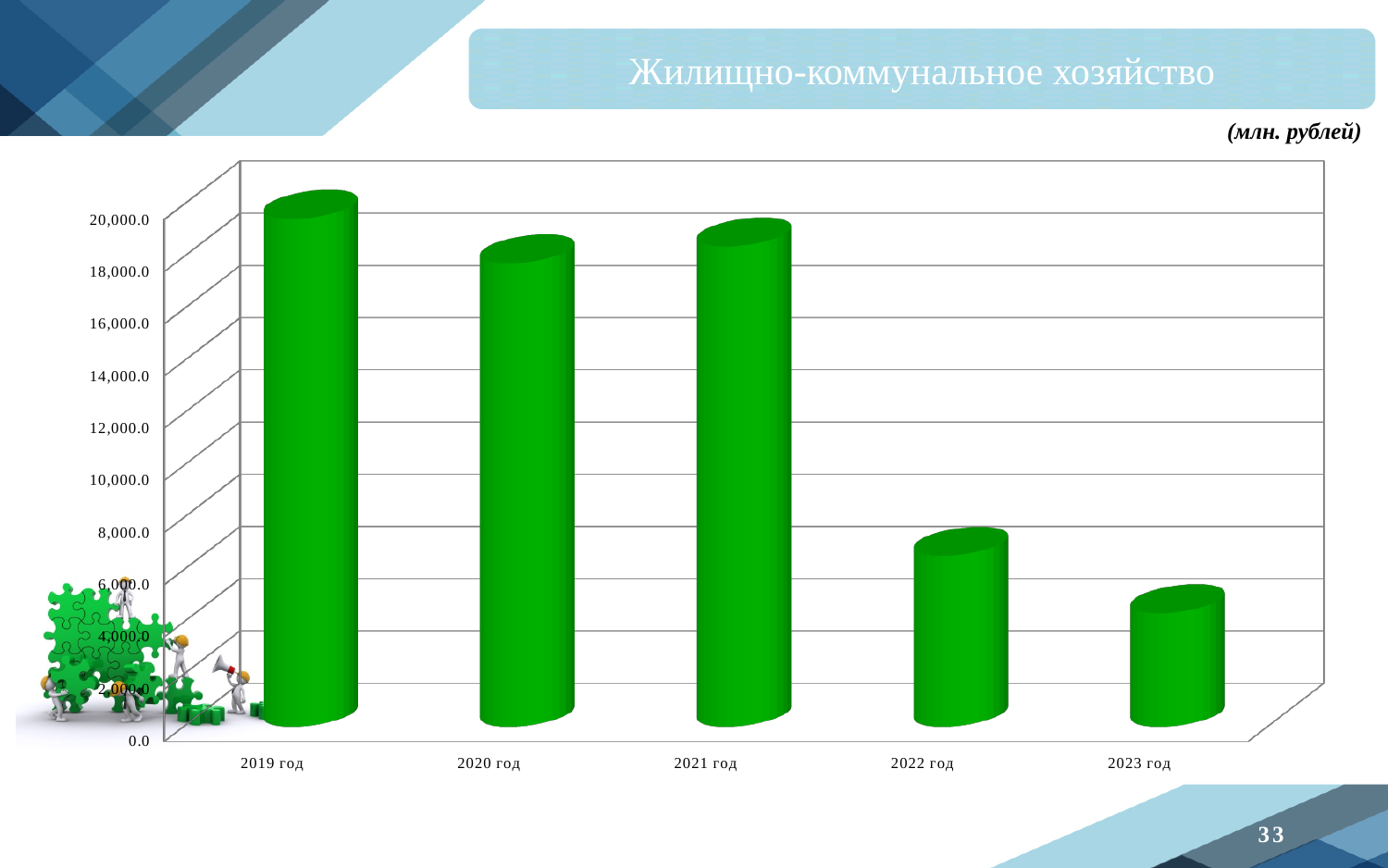
Is the value for 2023 год greater or less than 8,000.0? less What is the title of the chart on the slide? Жилищно-коммунальное хозяйство Is the value for 2022 год greater or less than 10,000.0? less Do the values generally rise or fall from 2019 год to 2023 год? fall Which year has the highest value in the chart? 2019 год Which year has the lowest value in the chart? 2023 год What kind of chart is shown on the slide? bar chart Which is larger, the value for 2022 год or the value for 2023 год? 2022 год Is the value for 2020 год greater or less than 14,000.0? greater Which is larger, the value for 2019 год or the value for 2023 год? 2019 год How many categories (years) are shown on the x axis of the chart? 5 In what units are the chart values given, according to the slide? млн. рублей